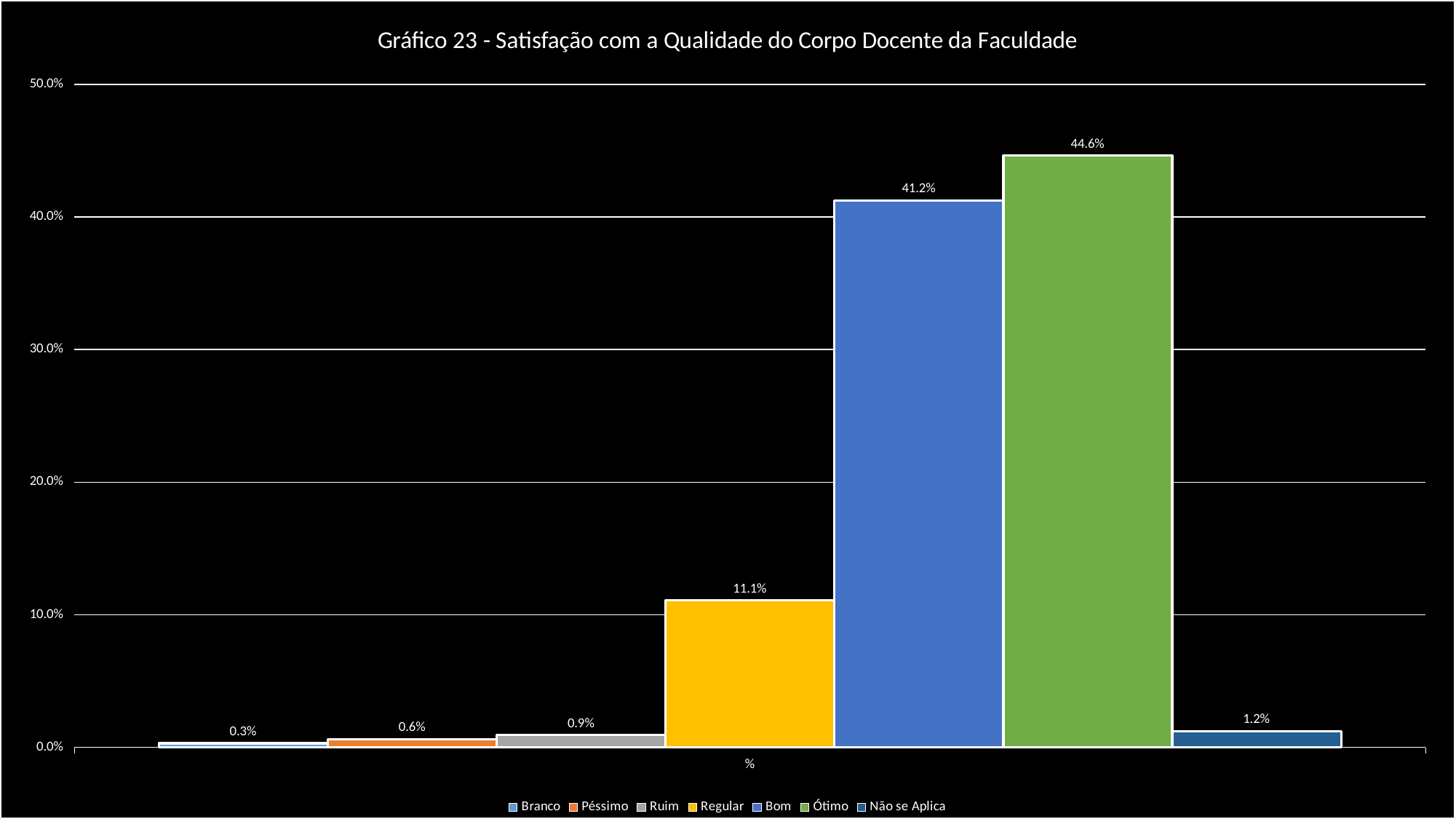
What is the value for Bom? 41.2% Is the value for Bom greater or less than 40.0%? greater Which series has the highest value? Ótimo How many series does the legend list? 7 What is the value for Não se Aplica? 1.2% What is the title of the chart? Gráfico 23 - Satisfação com a Qualidade do Corpo Docente da Faculdade What kind of chart is shown? Bar chart What is the value for Ótimo? 44.6% What is the value for Regular? 11.1% What is the difference between the values for Ótimo and Bom? 3.4% Which series has the lowest value? Branco Which is larger, the value for Regular or the value for Não se Aplica? Regular